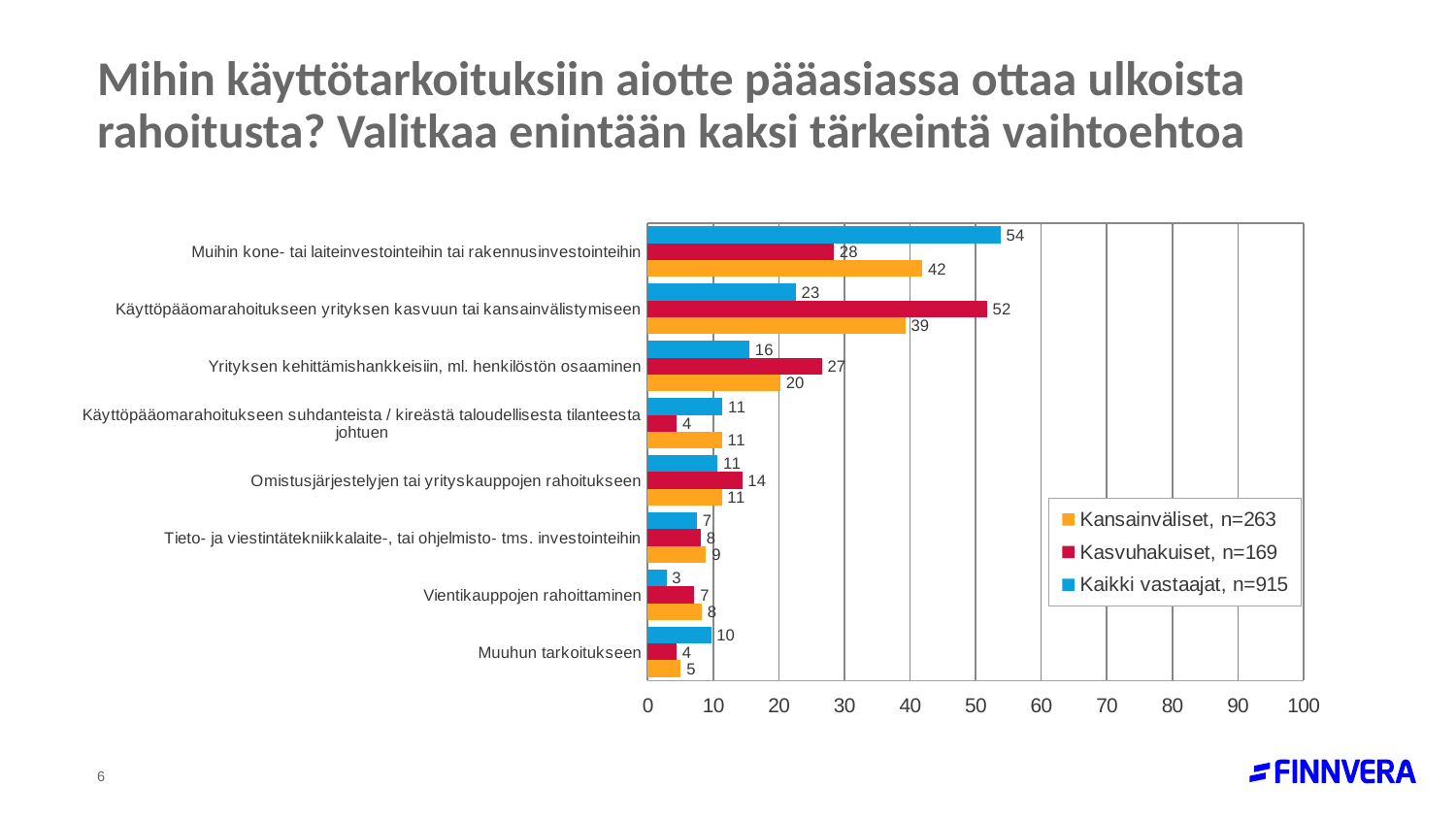
For 'Muuhun tarkoitukseen', which is larger: the Kaikki vastaajat value or the Kansainväliset value? Kaikki vastaajat What is the sample size (n) for the Kasvuhakuiset series in the legend? 169 What is the value for Kasvuhakuiset for 'Käyttöpääomarahoitukseen yrityksen kasvuun tai kansainvälistymiseen'? 52 How many categories are shown on the chart? 8 What is the value for Kansainväliset for 'Yrityksen kehittämishankkeisiin, ml. henkilöstön osaaminen'? 20 What is the difference between the Kasvuhakuiset and Kaikki vastaajat values for 'Käyttöpääomarahoitukseen yrityksen kasvuun tai kansainvälistymiseen'? 29 Which category has the lowest value for Kaikki vastaajat? Vientikauppojen rahoittaminen How many series does the legend list? 3 Which category has the highest value for Kaikki vastaajat? Muihin kone- tai laiteinvestointeihin tai rakennusinvestointeihin Is the Kansainväliset value for 'Muihin kone- tai laiteinvestointeihin tai rakennusinvestointeihin' greater or less than 40? greater What kind of chart is shown on the slide? bar chart What is the value for Kaikki vastaajat for 'Muihin kone- tai laiteinvestointeihin tai rakennusinvestointeihin'? 54